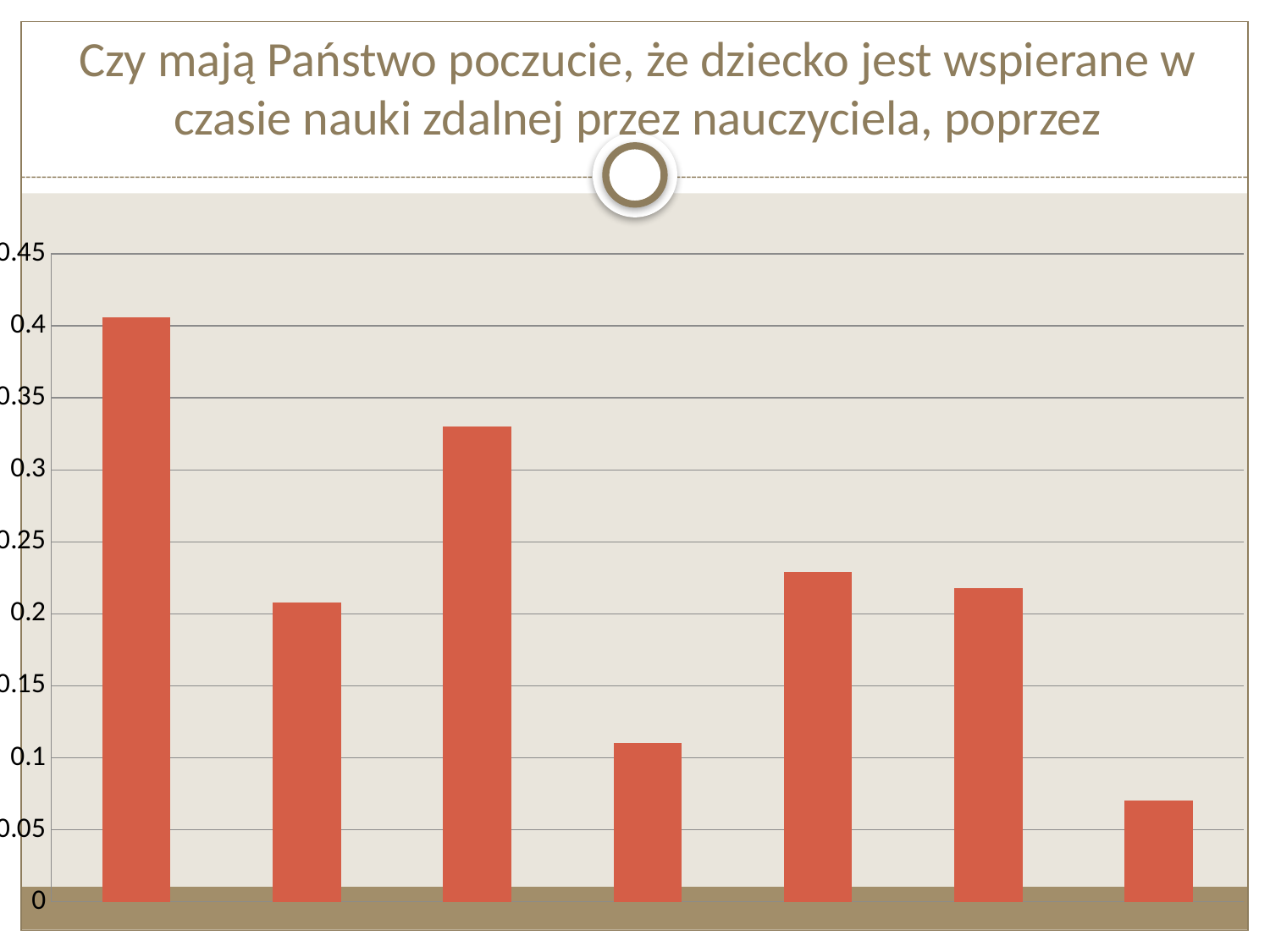
Is the value of the second bar from the left greater or less than 0.25? less Which bar is the tallest in the chart? the first bar (leftmost) Is the value of the first (leftmost) bar greater or less than 0.4? greater Is the value of the seventh (rightmost) bar greater or less than 0.1? less What is the title of the chart? Czy mają Państwo poczucie, że dziecko jest wspierane w czasie nauki zdalnej przez nauczyciela, poprzez Which is larger, the first bar or the third bar? the first bar Which is larger, the fourth bar or the fifth bar? the fifth bar How many bars are plotted in the chart? 7 Which bar is the shortest in the chart? the seventh bar (rightmost) What kind of chart is shown on the slide? bar chart